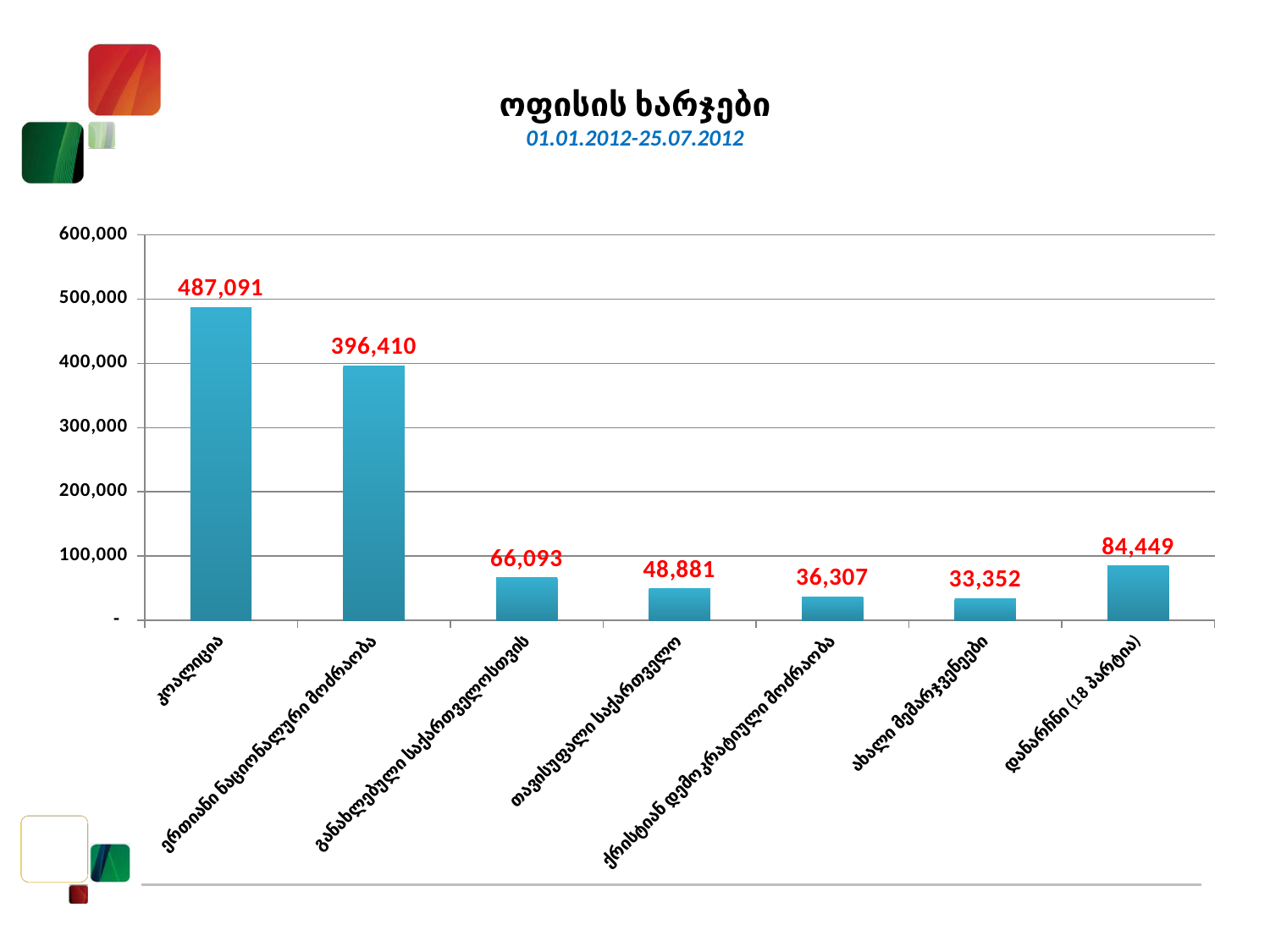
What is the value for დანარჩენი (18 პარტია)? 84,449 What is the value for კოალიცია? 487,091 How many categories are shown on the chart? 7 What kind of chart is shown on the slide? bar chart What is the value for ერთიანი ნაციონალური მოძრაობა? 396,410 What is the difference between the values for კოალიცია and ერთიანი ნაციონალური მოძრაობა? 90,681 What is the value for ახალი მემარჯვენეები? 33,352 Is the value for ქრისტიან დემოკრატიული მოძრაობა greater or less than 100,000? less Which category has the lowest value? ახალი მემარჯვენეები Which is larger, the value for განახლებული საქართველოსთვის or the value for თავისუფალი საქართველო? განახლებული საქართველოსთვის Which category has the highest value? კოალიცია What date range is shown in the chart's subtitle? 01.01.2012-25.07.2012